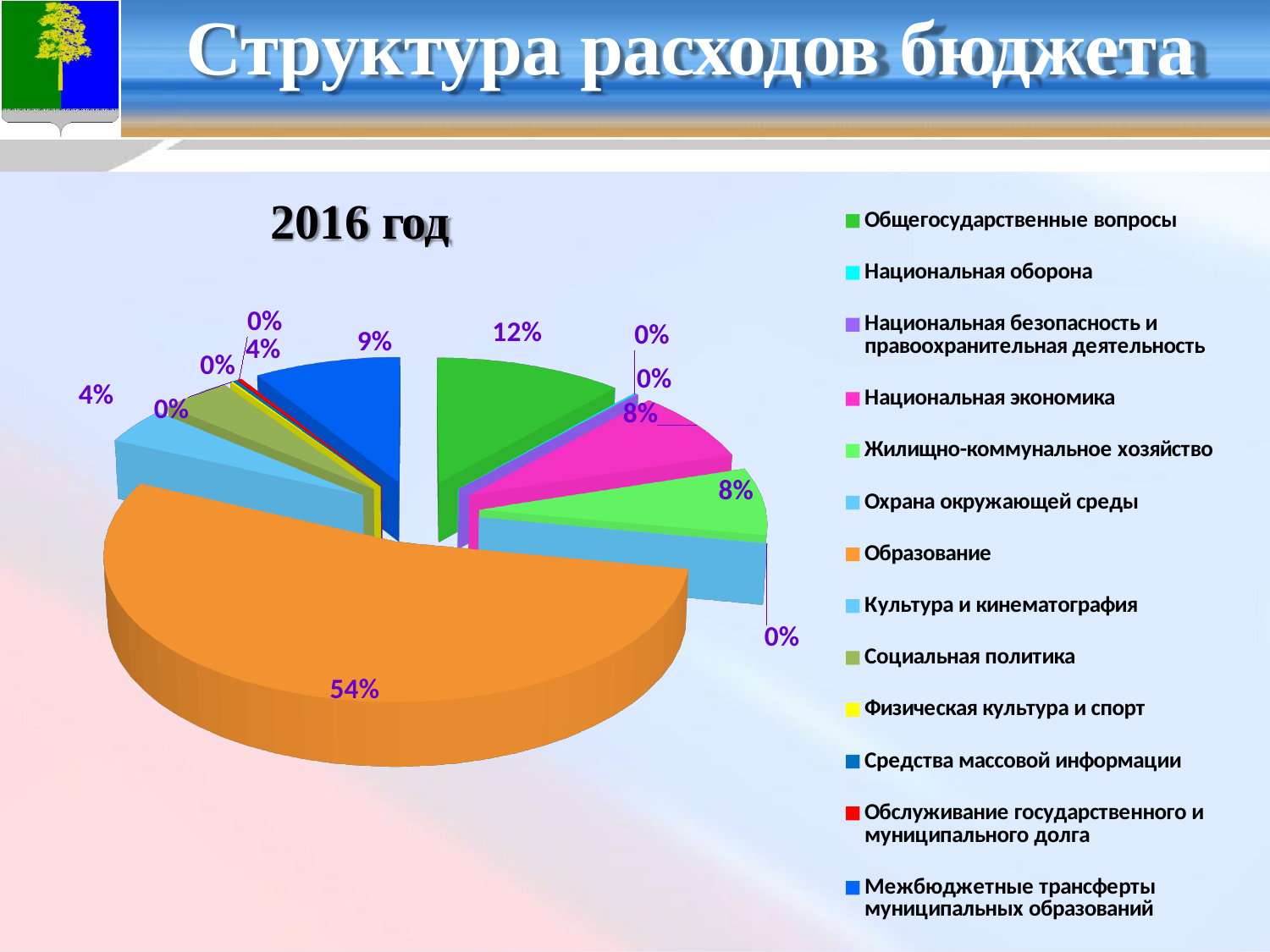
What is the value for Жилищно-коммунальное хозяйство? 8% What is the difference in percentage points between Образование and Общегосударственные вопросы? 42 What is the value for Общегосударственные вопросы? 12% What is the value for Культура и кинематография? 4% What is the title of the chart? 2016 год Which is larger, the share for Образование or the share for Общегосударственные вопросы? Образование What is the value for Национальная экономика? 8% How many categories does the legend list? 13 What kind of chart is shown on the slide? pie chart Which category has the largest share of the pie? Образование What share of the pie does Образование have? 54% What is the value for Национальная оборона? 0%